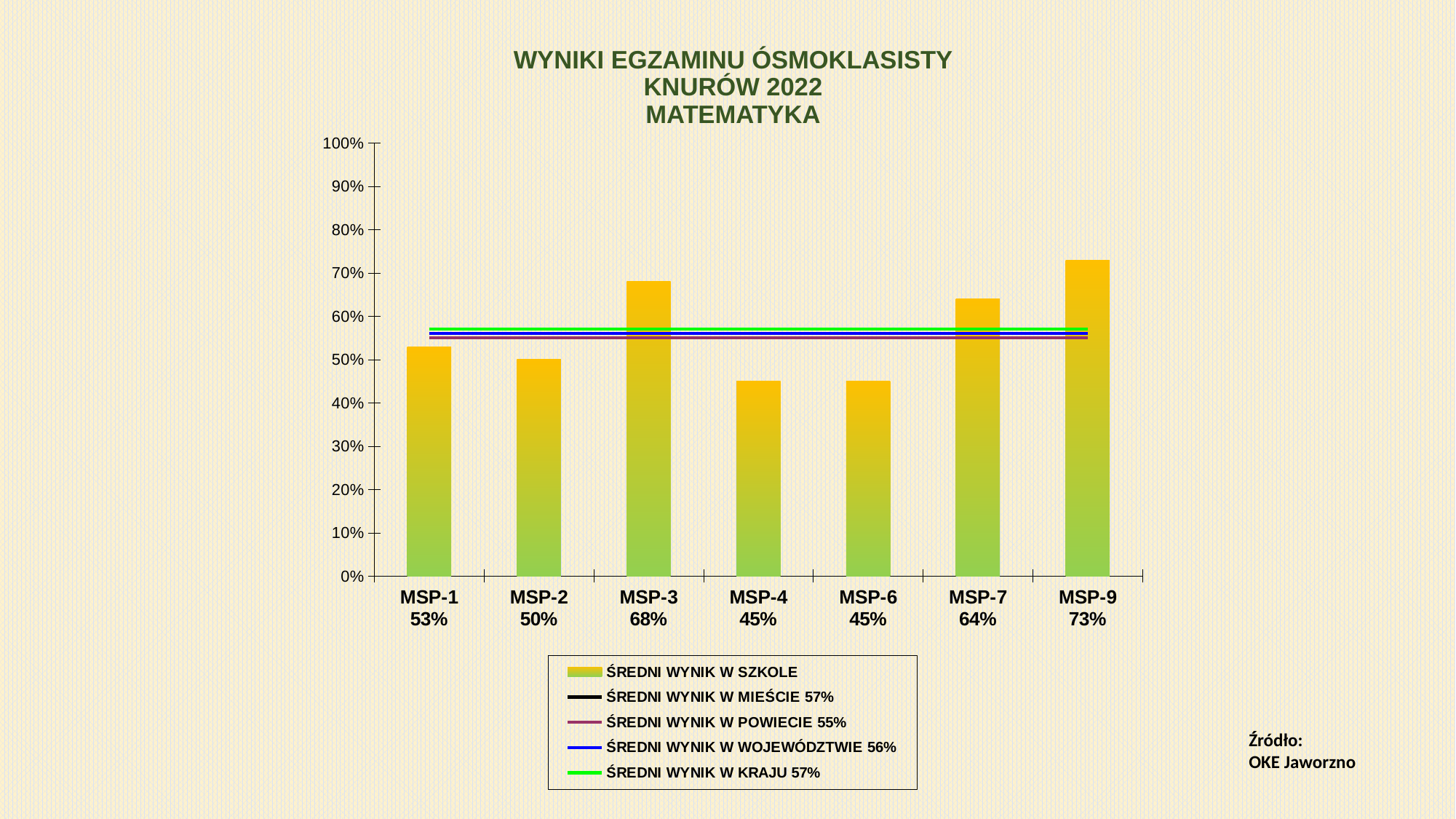
What is the average result for MSP-7? 64% What subject does the chart title refer to? MATEMATYKA How many series does the legend list? 5 What kind of chart is this? combination bar and line chart What is the average result for MSP-3? 68% What is the difference between the results of MSP-9 and MSP-2? 23% Which is larger, the result for MSP-1 or the result for MSP-7? MSP-7 What is the average result in the voivodeship (ŚREDNI WYNIK W WOJEWÓDZTWIE) according to the legend? 56% Is the value for MSP-4 greater or less than 50%? less What is the average result in the county (ŚREDNI WYNIK W POWIECIE) according to the legend? 55% How many schools are shown on the x axis? 7 Which school has the highest average result? MSP-9